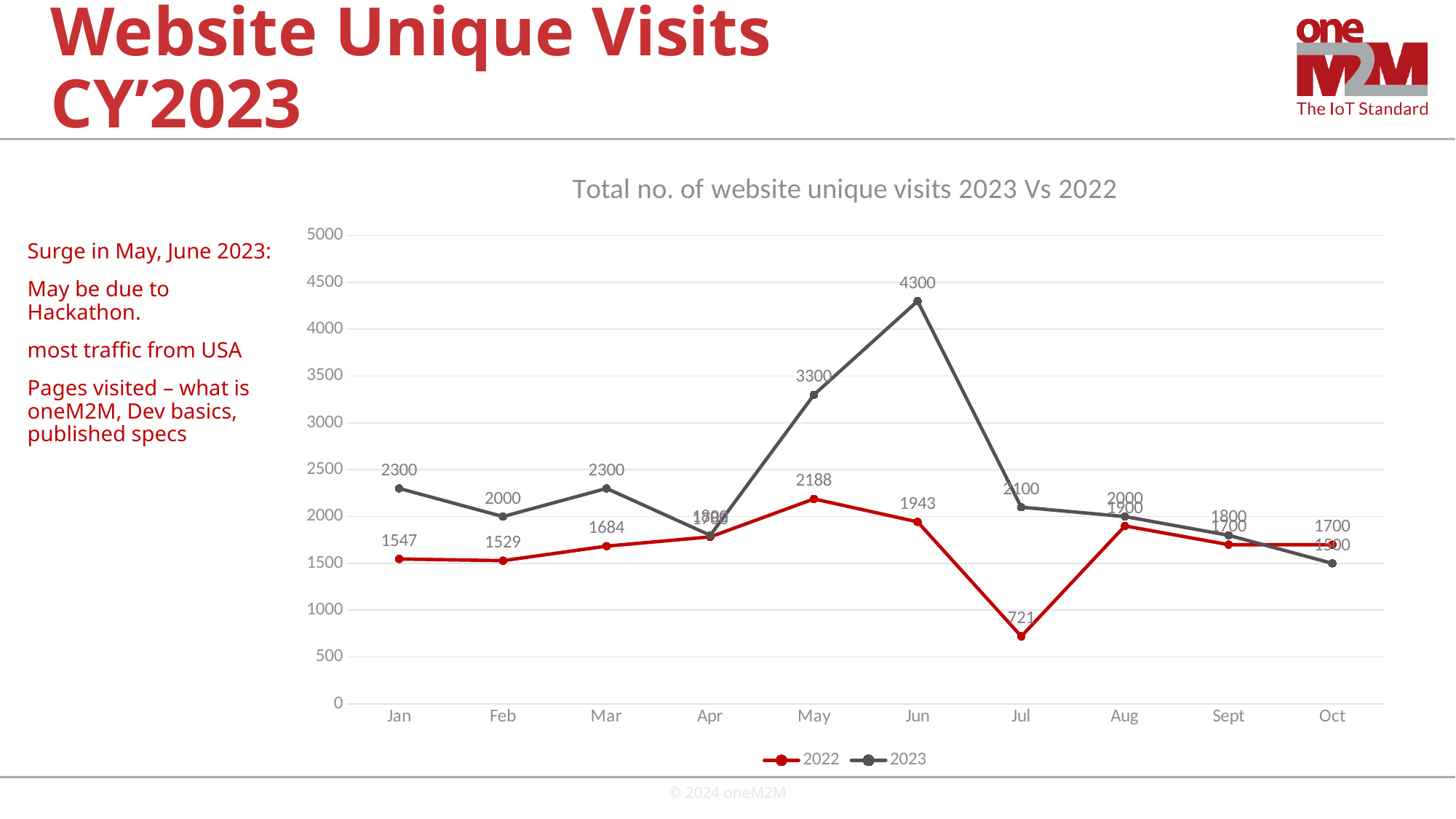
What is the value for 2022 in May? 2188 How many series does the legend list? 2 What is the value for 2023 in Jan? 2300 What is the value for 2023 in Jun? 4300 What is the value for 2022 in Jul? 721 In which month does the 2022 series reach its lowest value? Jul Is the value for 2023 in Apr greater or less than 2000? less In which month does the 2023 series reach its highest value? Jun What is the difference between the 2023 and 2022 values in Jun? 2357 What kind of chart is shown on the slide? line chart How many months are shown on the x axis? 10 Which series has the larger value in May, 2022 or 2023? 2023